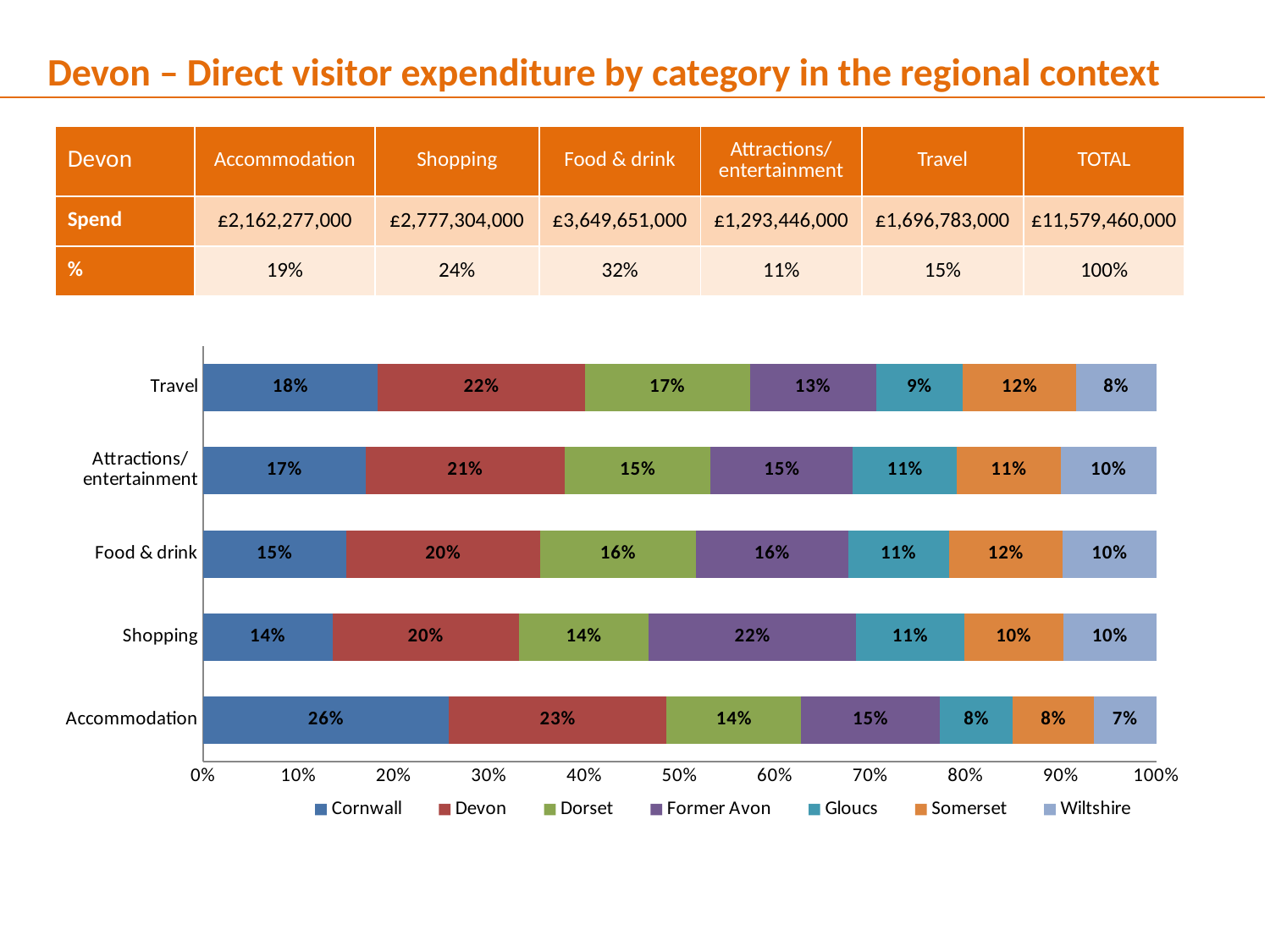
In which category does Wiltshire have its lowest share in the chart? Accommodation In the Shopping bar, which is larger: Former Avon's share or Dorset's share? Former Avon How many series does the chart legend list? 7 Which series is shown in red in the chart? Devon What is Cornwall's share of the Travel bar in the chart? 18% What is Wiltshire's share of the Food & drink bar in the chart? 10% What kind of chart is shown on the slide? Stacked bar chart How many categories are shown on the chart's vertical axis? 5 What is Devon's share of the Accommodation bar in the chart? 23% What is the difference between Cornwall's and Devon's shares of the Accommodation bar? 3% In which category does Cornwall have its highest share in the chart? Accommodation What is Former Avon's share of the Shopping bar in the chart? 22%